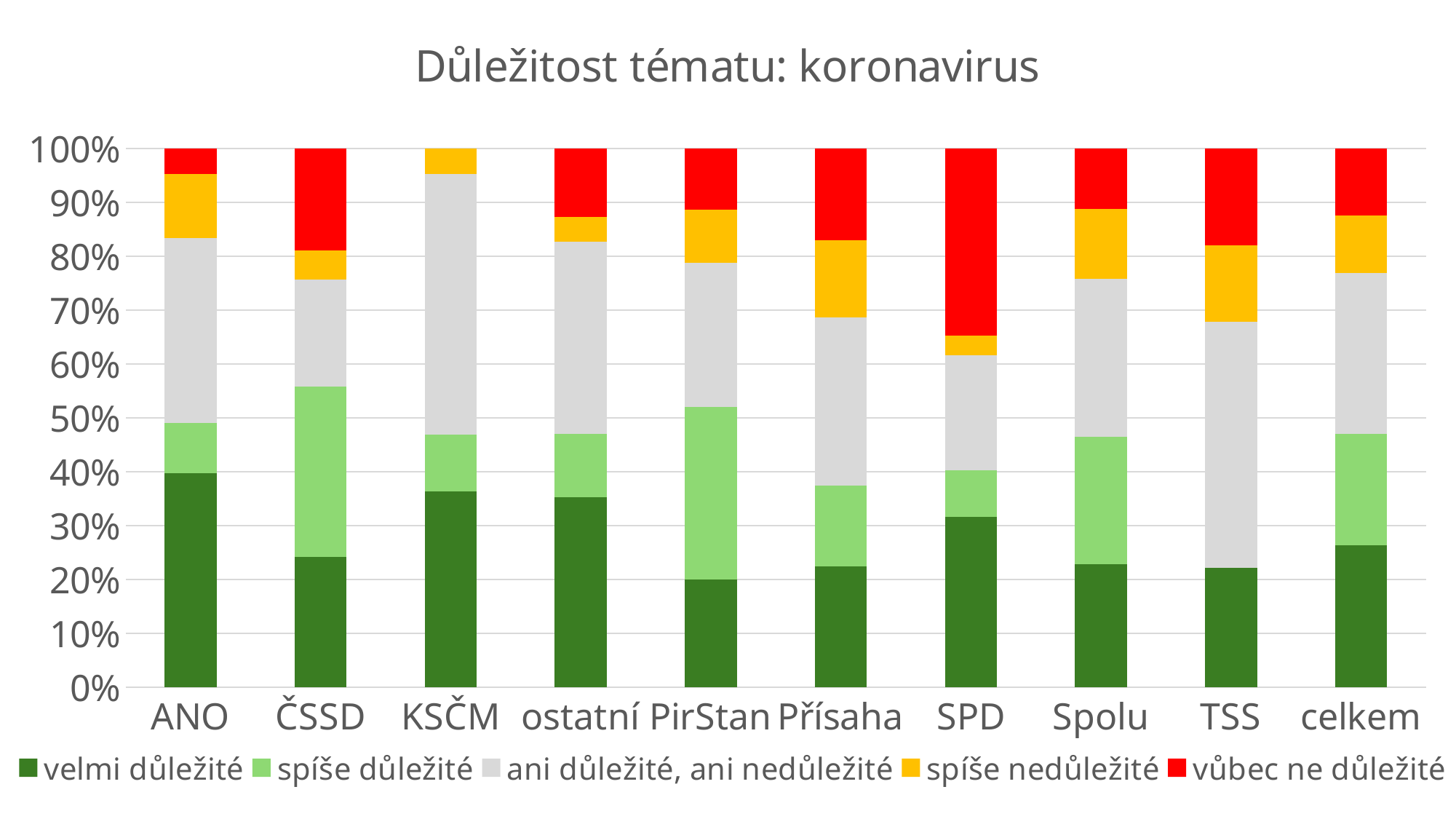
Which is larger, the 'velmi důležité' segment for ANO or for ČSSD? ANO Is the 'velmi důležité' value for KSČM greater or less than 30%? greater Is the 'velmi důležité' value for celkem greater or less than 20%? greater Which category has the largest 'vůbec ne důležité' segment? SPD What does each stacked bar total? 100% Which category has no visible 'vůbec ne důležité' segment? KSČM Which category has the largest 'velmi důležité' segment? ANO What kind of chart is shown on the slide? stacked bar chart What is the title of the chart? Důležitost tématu: koronavirus How many categories are shown on the x axis? 10 How many series does the legend list? 5 Is the 'velmi důležité' value for ČSSD greater or less than 30%? less